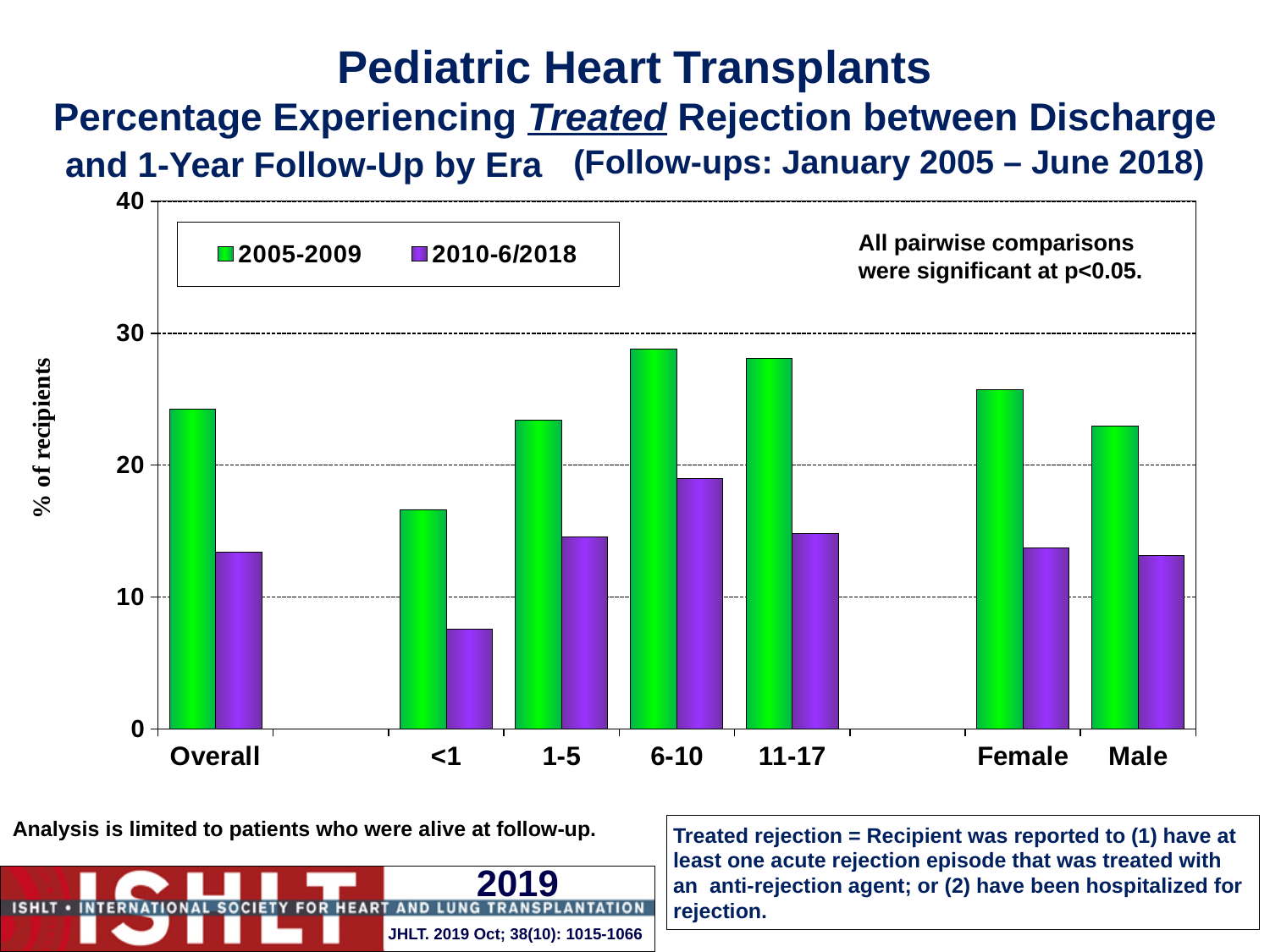
Is the value for <1 in the 2010-6/2018 series greater or less than 10? less Which category has the highest value for the 2010-6/2018 series? 6-10 How many categories are shown along the x axis? 7 Is the value for 6-10 in the 2005-2009 series greater or less than 30? less Which category has the lowest value for the 2010-6/2018 series? <1 Which category has the lowest value for the 2005-2009 series? <1 Is the value for Overall in the 2005-2009 series greater or less than 20? greater What kind of chart is shown on the slide? bar chart In the 2010-6/2018 series, which is larger, the value for 6-10 or the value for 11-17? 6-10 How many series does the legend list? 2 What is the label of the y axis? % of recipients For the Female category, which series has the larger value, 2005-2009 or 2010-6/2018? 2005-2009